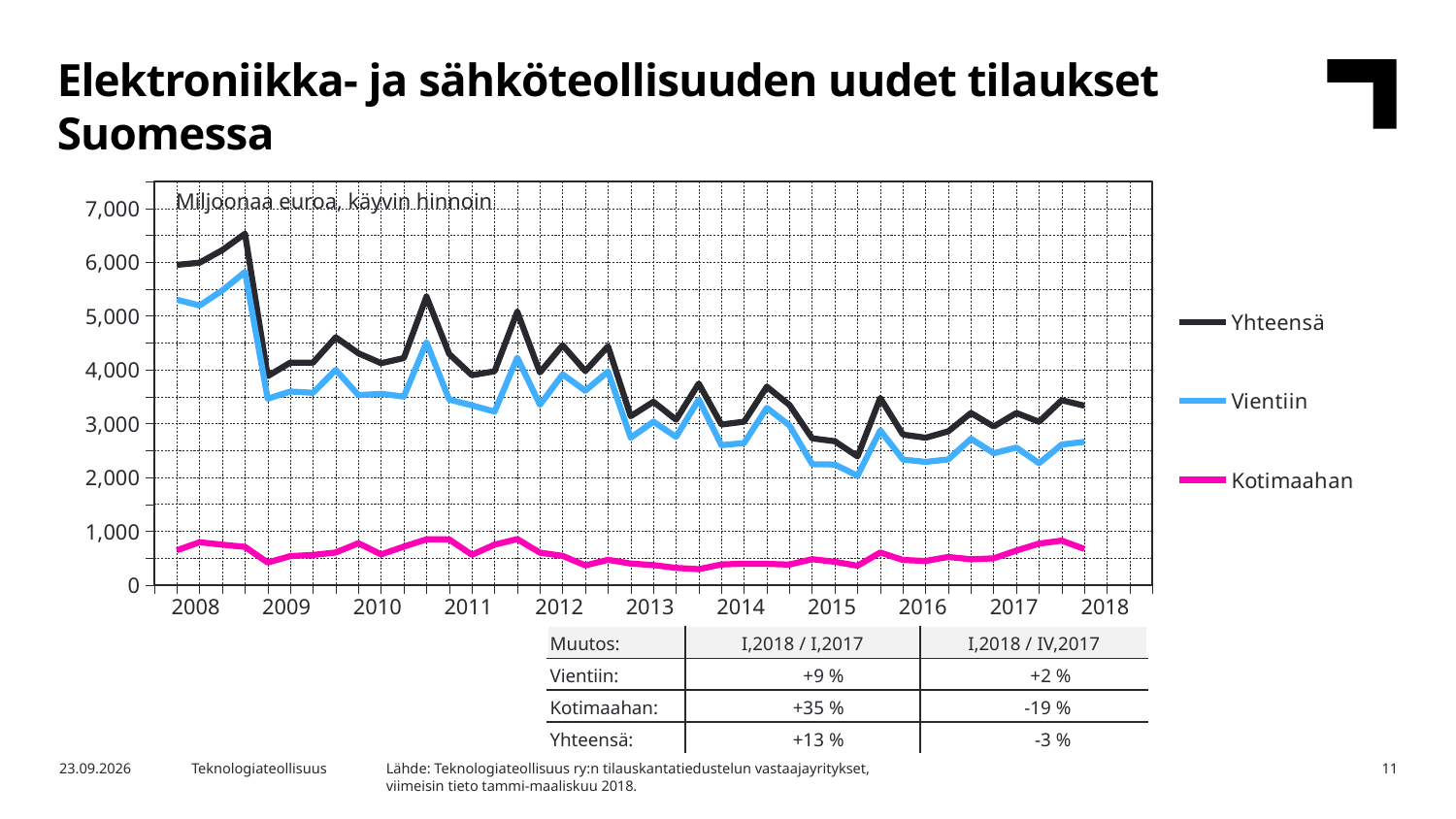
How many series does the legend list? 3 Which series are listed in the legend? Yhteensä, Vientiin, Kotimaahan Which is larger in 2018, the value for Vientiin or the value for Kotimaahan? Vientiin Is the peak value for Yhteensä in 2008 greater or less than 6,000? greater Does the Yhteensä line rise or fall overall from 2008 to 2018? Fall What unit is stated at the top of the chart area? Miljoonaa euroa, käyvin hinnoin Is the value for Vientiin at the start of 2018 greater or less than 3,000? less Which series has the lowest values across the whole period? Kotimaahan What kind of chart is shown on the slide? Line chart How many year labels are shown on the x axis? 11 Which series has the highest values across the whole period? Yhteensä Is the value for Kotimaahan at the start of 2008 greater or less than 1,000? less